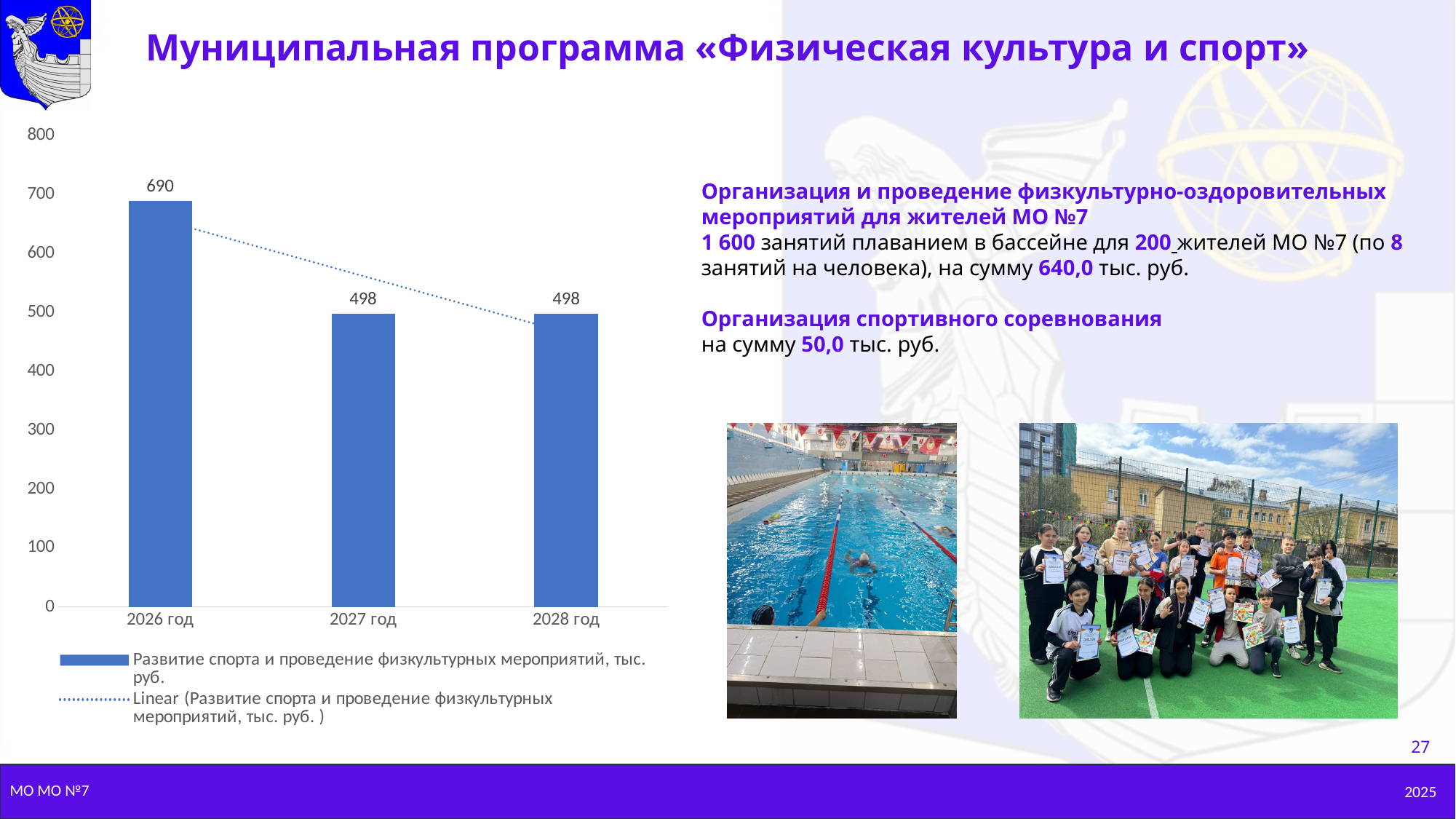
How many entries does the legend list? 2 Do the values rise or fall from 2026 год to 2027 год? fall What is the value for 2028 год? 498 How many years are shown on the x axis? 3 Which year has the highest value? 2026 год What is the difference between the values for 2026 год and 2027 год? 192 What is the value for 2027 год? 498 Is the value for 2026 год greater or less than 600? greater What is the value for 2026 год? 690 What kind of chart is this? bar chart Is the value for 2027 год greater or less than 500? less Which is larger, the value for 2026 год or the value for 2028 год? 2026 год